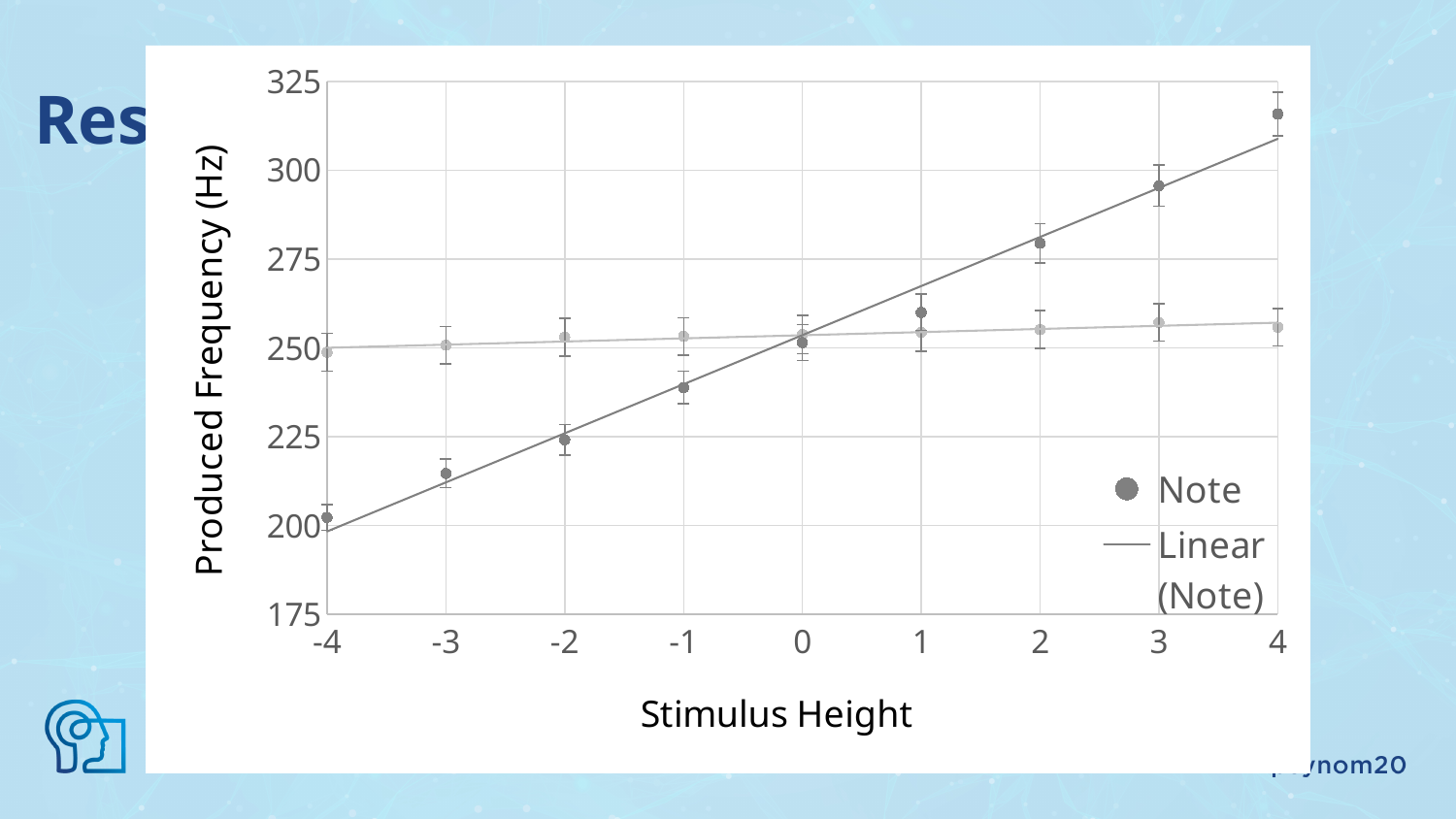
How many entries does the legend list? 2 Do the Note values rise or fall as stimulus height increases from -4 to 4? rise What is the title of the x axis? Stimulus Height At which stimulus height is the Note value lowest? -4 What is the title of the y axis? Produced Frequency (Hz) At which stimulus height is the Note value highest? 4 Is the Note value at stimulus height -4 greater or less than 225? less How many stimulus height values are plotted for the Note series? 9 What kind of chart is shown on the slide? scatter chart Is the Note value at stimulus height -2 greater or less than 250? less Which is larger, the Note value at stimulus height 3 or at stimulus height -3? stimulus height 3 Is the Note value at stimulus height 4 greater or less than 300? greater